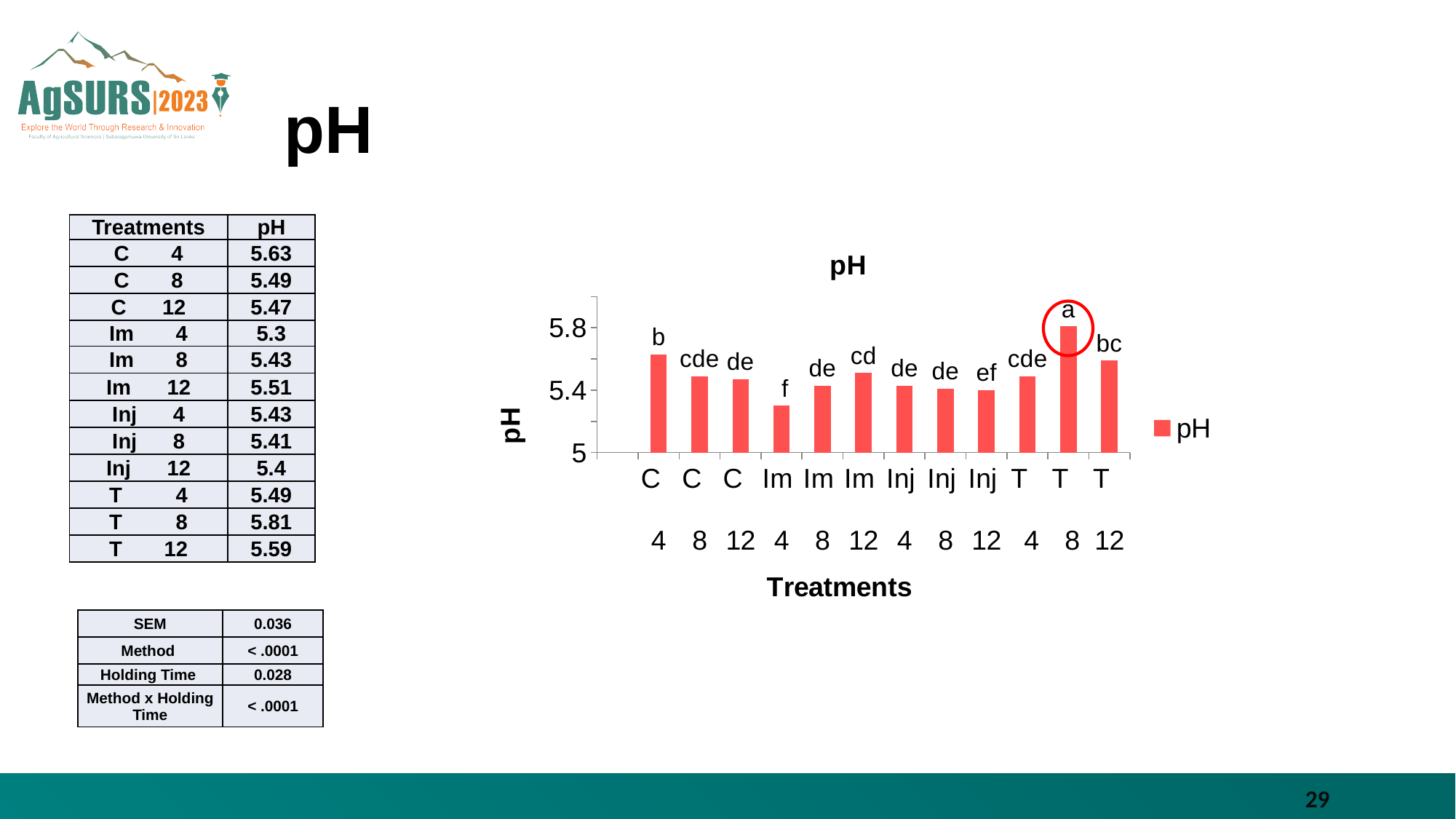
How many bars does the pH chart have? 12 How many series does the legend of the pH chart list? 1 According to the table on the slide, what is the pH for treatment T 8? 5.81 Is the pH value for treatment T 8 greater or less than 5.4? greater Which treatment has the lowest pH in the chart? Im 4 Which treatment has the highest pH in the chart? T 8 Is the pH value for treatment Im 4 greater or less than 5.4? less Which has a higher pH, treatment C 4 or treatment Im 4? C 4 What is the x-axis title of the chart? Treatments According to the table on the slide, what is the pH for treatment Im 4? 5.3 What is the title of the chart? pH What kind of chart is shown on the slide? bar chart